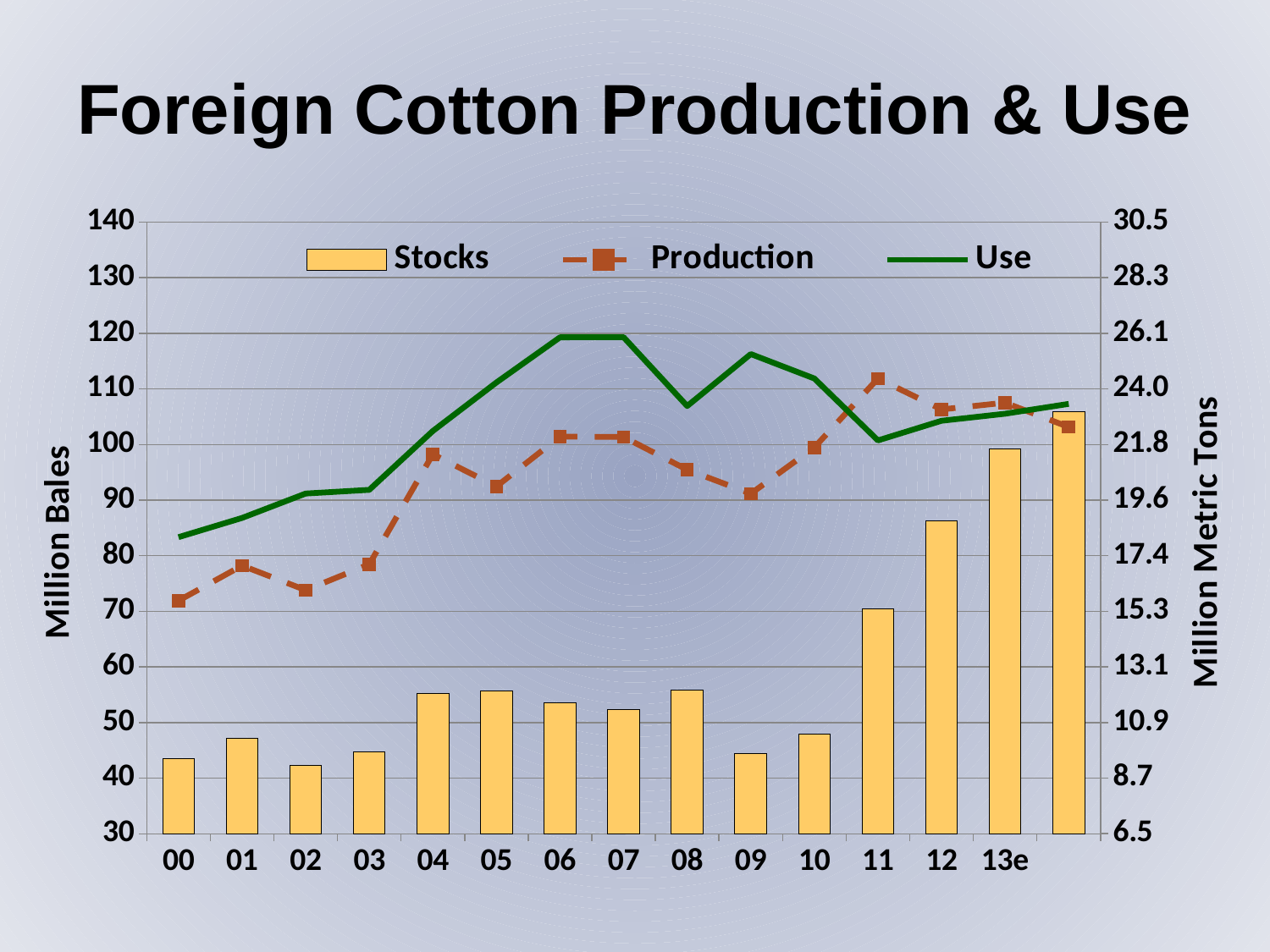
Is the Stocks value for 11 greater or less than 60 million bales? greater Is the Use value for 06 greater or less than 24.0 million metric tons? greater Is the Production value for 00 greater or less than 17.4 million metric tons? less Do Stocks rise or fall from 10 to 13e? rise How many series does the legend list? 3 What kind of chart is shown on the slide? A combination bar and line chart In 11, which is higher, Production or Use? Production In 06, which is higher, Use or Production? Use Which series is drawn as bars? Stocks What is the title of the left vertical axis? Million Bales